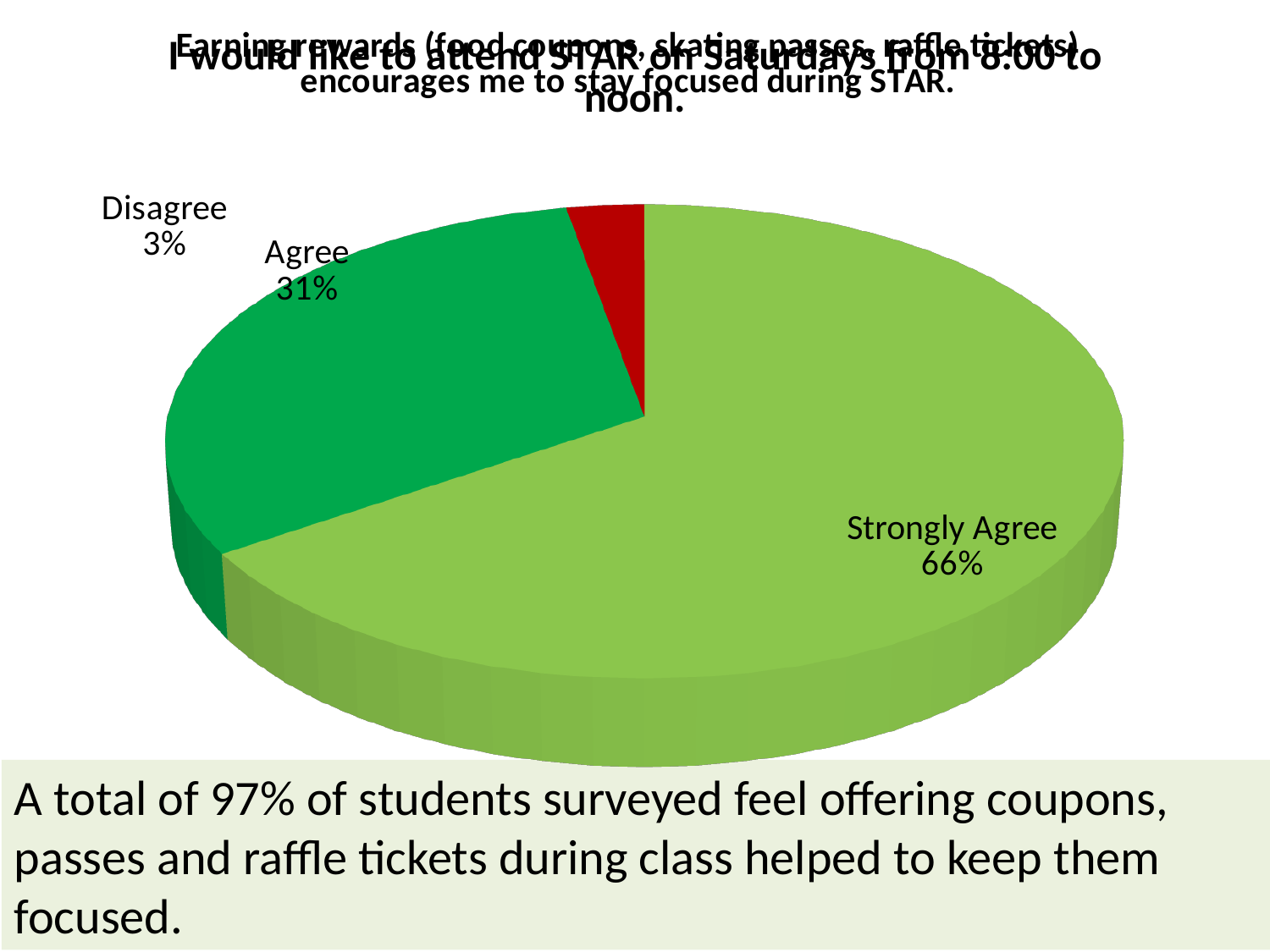
What colour is the Disagree slice? Red What percentage of the pie is labelled Strongly Agree? 66% What is the difference in percentage points between the Strongly Agree and Agree slices? 35 How many slices does the pie chart have? 3 Which category has the smallest slice of the pie? Disagree Which category has the largest slice of the pie? Strongly Agree What kind of chart is shown on the slide? Pie chart What is the difference in percentage points between the Agree and Disagree slices? 28 What percentage of the pie is labelled Disagree? 3% What is the combined share of the Strongly Agree and Agree slices? 97% What percentage of the pie is labelled Agree? 31% Which slice is larger, Agree or Disagree? Agree